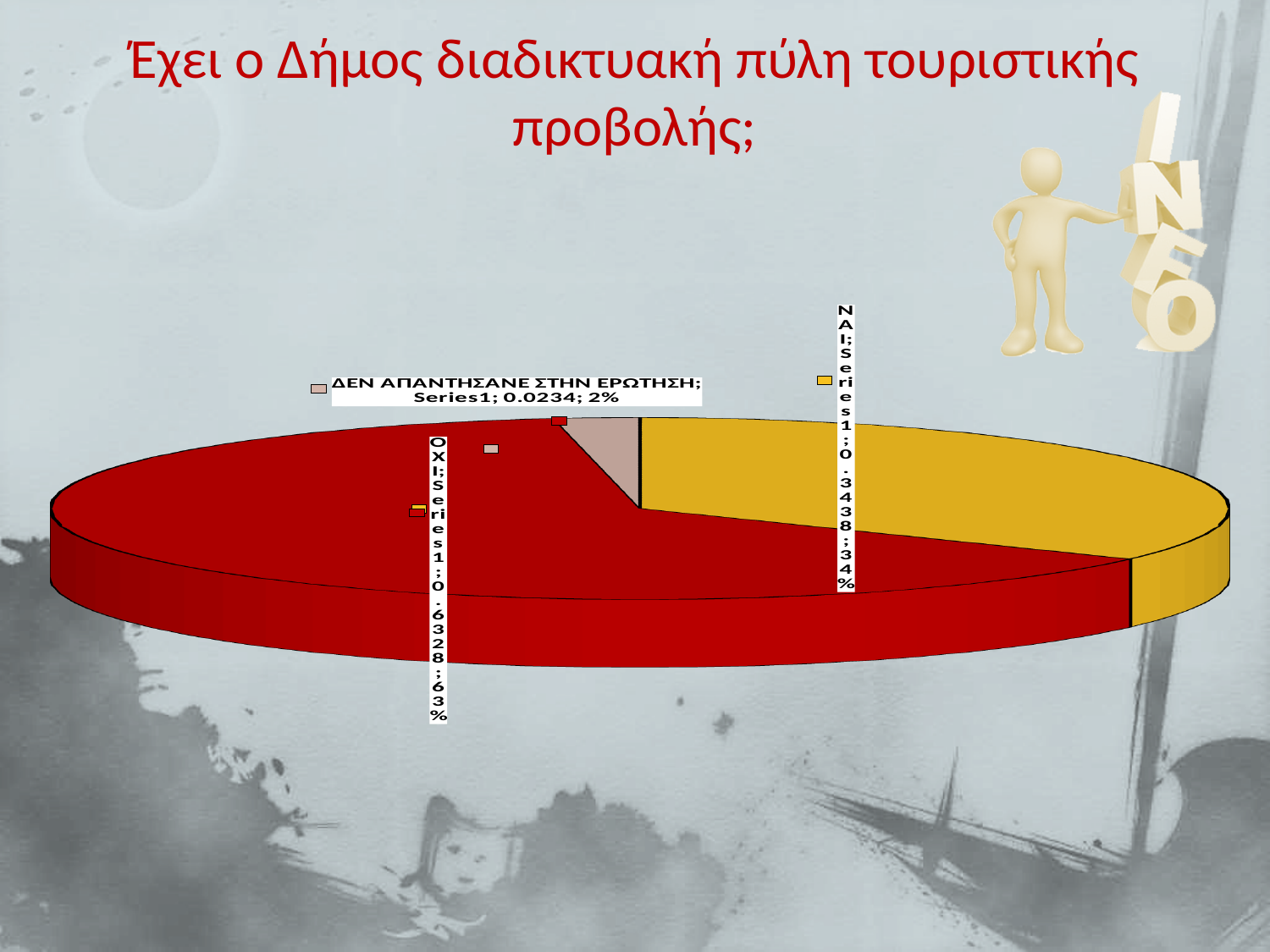
What colour is the ΝΑΙ slice of the pie chart? yellow What is the difference in percentage points between the ΟΧΙ slice and the ΝΑΙ slice? 29 What percentage is shown for the ΟΧΙ slice? 63% What decimal value is printed in the data label for ΟΧΙ? 0.6328 What kind of chart is shown on the slide? pie chart Which slice of the pie chart is the largest? ΟΧΙ Which slice of the pie chart is the smallest? ΔΕΝ ΑΠΑΝΤΗΣΑΝΕ ΣΤΗΝ ΕΡΩΤΗΣΗ What decimal value is printed in the data label for ΝΑΙ? 0.3438 Which is larger, the ΝΑΙ slice or the ΟΧΙ slice? ΟΧΙ How many slices does the pie chart have? 3 What percentage is shown for the ΔΕΝ ΑΠΑΝΤΗΣΑΝΕ ΣΤΗΝ ΕΡΩΤΗΣΗ slice? 2% What percentage is shown for the ΝΑΙ slice? 34%